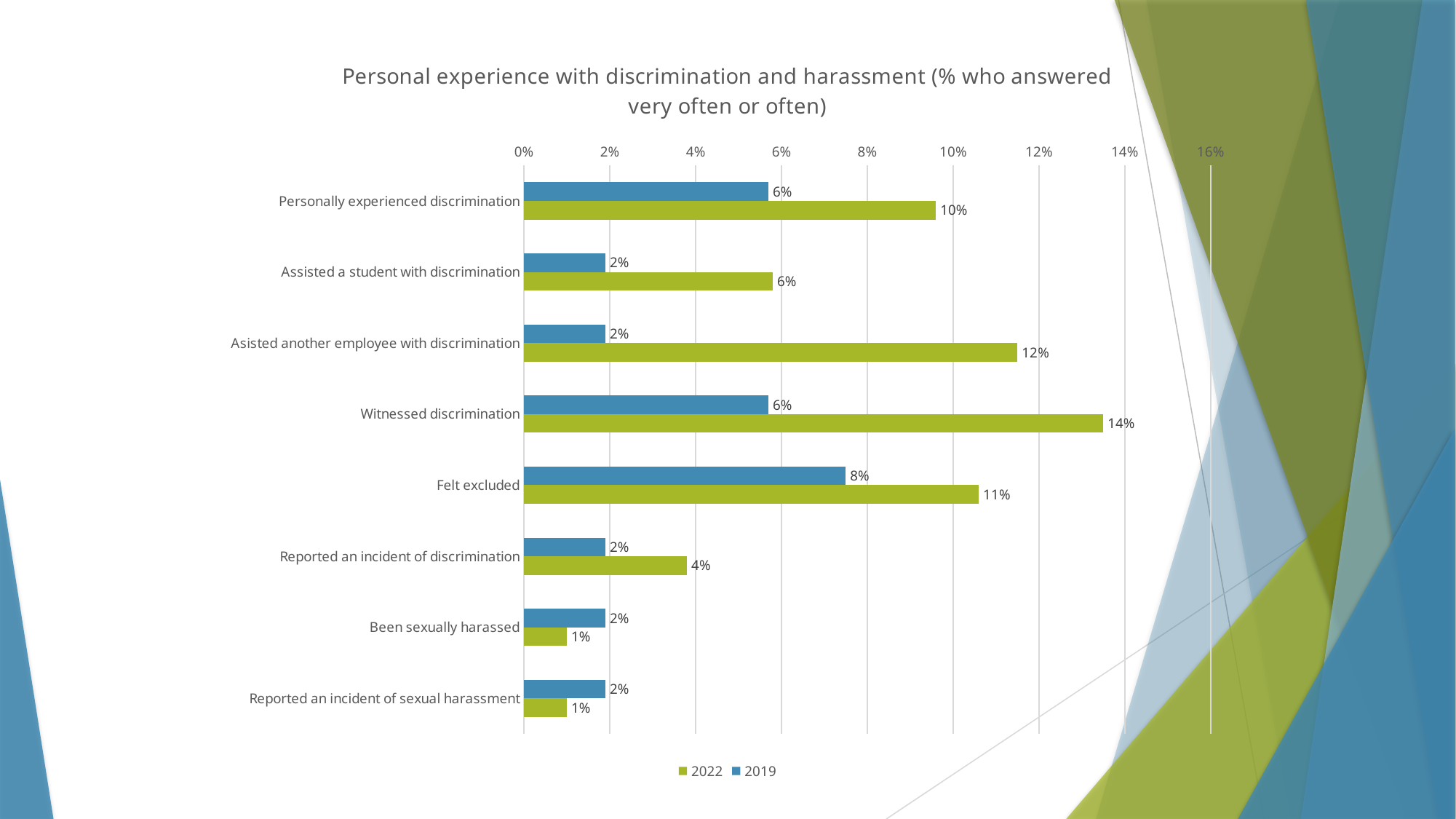
Which colour represents the 2022 series? Green Which category has the highest 2022 value? Witnessed discrimination Which is larger for Felt excluded, the 2022 value or the 2019 value? 2022 Which is larger for Been sexually harassed, the 2022 value or the 2019 value? 2019 What kind of chart is shown on the slide? Bar chart What is the difference between the 2022 and 2019 values for Personally experienced discrimination? 4% What is the 2019 value for Felt excluded? 8% Which category has the highest 2019 value? Felt excluded How many series does the legend list? 2 What is the 2022 value for Asisted another employee with discrimination? 12% How many categories are shown on the chart? 8 What is the 2022 value for Witnessed discrimination? 14%